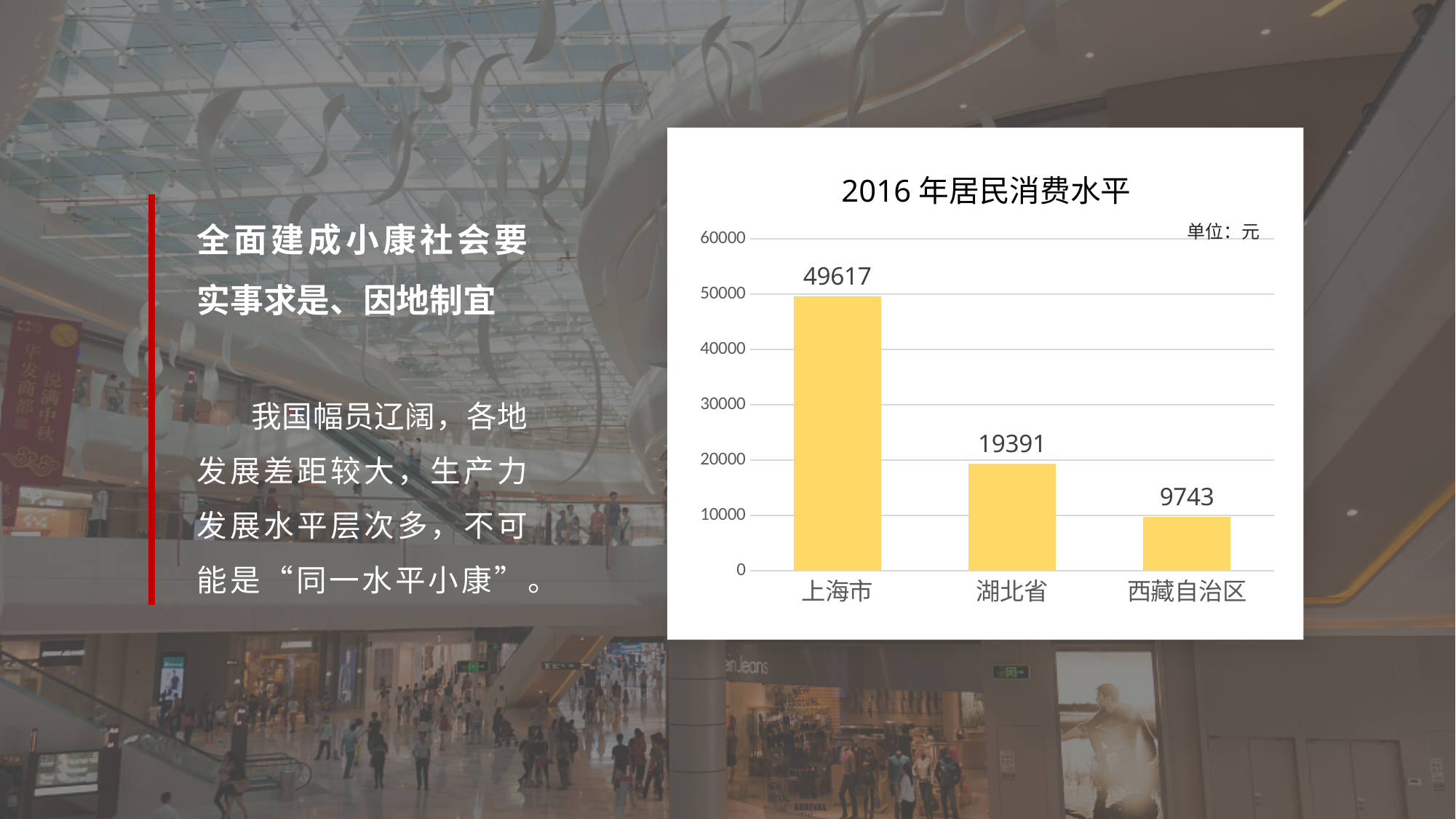
How many categories are shown in the chart? 3 Which category has the highest value? 上海市 What is the value for 湖北省? 19391 What is the difference between the values for 上海市 and 湖北省? 30226 Which is larger, the value for 湖北省 or the value for 西藏自治区? 湖北省 What is the difference between the values for 湖北省 and 西藏自治区? 9648 Which category has the lowest value? 西藏自治区 What kind of chart is shown on the slide? bar chart Is the value for 上海市 greater or less than 40000? greater What is the title of the chart? 2016 年居民消费水平 What is the value for 上海市? 49617 What is the value for 西藏自治区? 9743